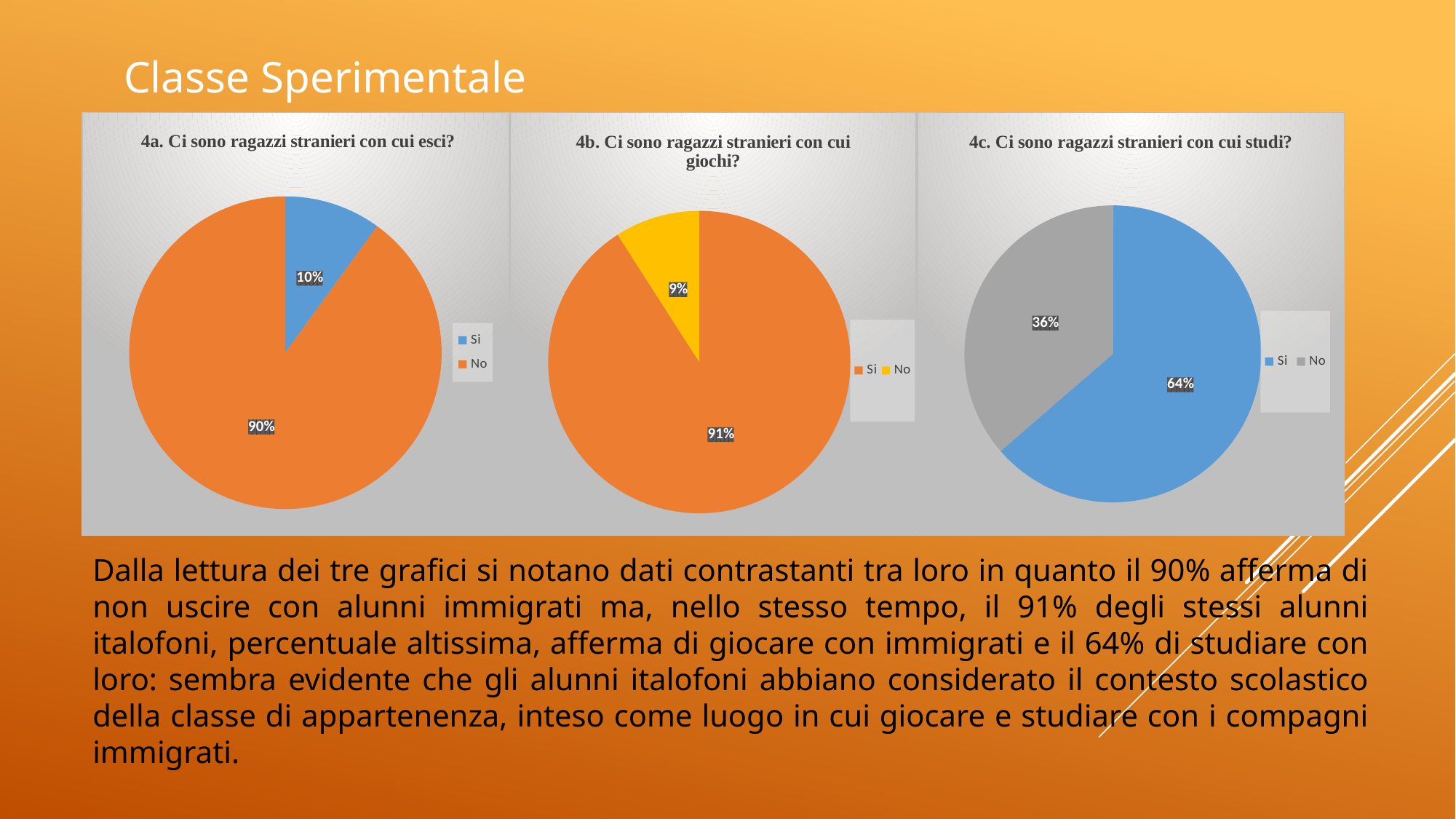
In the chart titled "4c. Ci sono ragazzi stranieri con cui studi?", what is the value for "Si"? 64% In the chart titled "4c. Ci sono ragazzi stranieri con cui studi?", what is the difference between the "Si" and "No" values? 28% In the chart titled "4b. Ci sono ragazzi stranieri con cui giochi?", what is the value for "Si"? 91% In the chart titled "4c. Ci sono ragazzi stranieri con cui studi?", which category is the largest? Si In the chart titled "4c. Ci sono ragazzi stranieri con cui studi?", what is the value for "No"? 36% In the chart titled "4a. Ci sono ragazzi stranieri con cui esci?", what share of the pie is "No"? 90% How many categories does the legend of the chart titled "4a. Ci sono ragazzi stranieri con cui esci?" list? 2 In the chart titled "4a. Ci sono ragazzi stranieri con cui esci?", what is the value for "Si"? 10% In the chart titled "4b. Ci sono ragazzi stranieri con cui giochi?", which is larger, "Si" or "No"? Si What kind of chart is the chart titled "4b. Ci sono ragazzi stranieri con cui giochi?"? Pie chart In the chart titled "4b. Ci sono ragazzi stranieri con cui giochi?", what share of the pie is "No"? 9% In the chart titled "4a. Ci sono ragazzi stranieri con cui esci?", which category is the smallest? Si